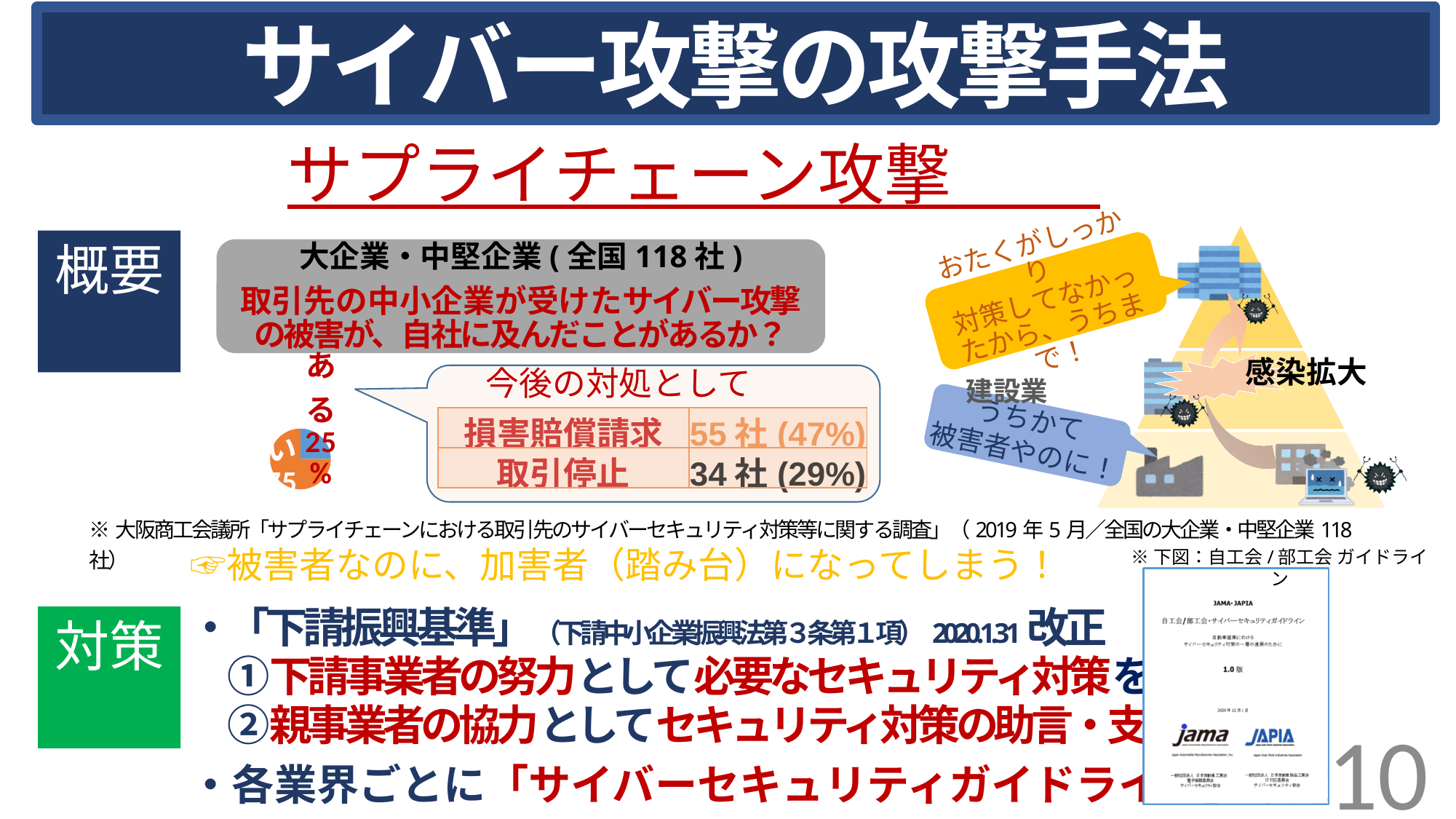
In the pie chart, is the slice labelled ある the larger or the smaller of the two slices? smaller What kind of chart is shown next to the 概要 section (below the grey box)? pie chart In the pie chart, what share is labelled for ある? 25% In the pie chart, is the share for ある greater or less than 50%? less How many slices does the pie chart have? 2